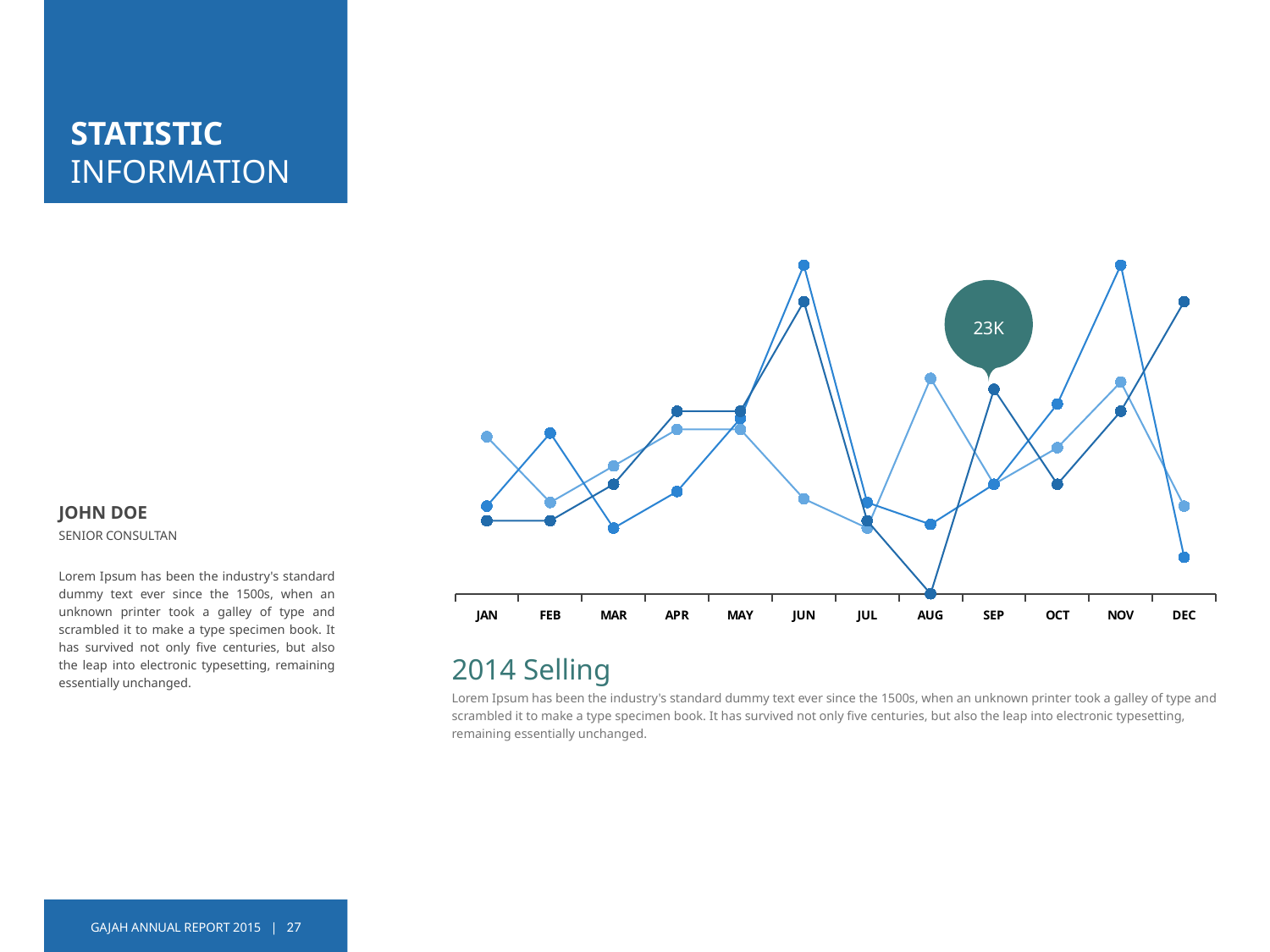
Which month does the 23K callout point to? SEP In which month does the lowest point on the chart occur? AUG What value is shown in the callout label on the chart? 23K How many lines are plotted on the chart? 3 What kind of chart is shown on the slide? line chart What colour is the callout bubble showing 23K? teal green For the darkest blue line, does the value rise or fall from JUN to AUG? fall For the darkest blue line, is the value higher in JUN or in JUL? JUN For the lightest blue line, is the value higher in JAN or in FEB? JAN For the darkest blue line, does the value rise or fall from NOV to DEC? rise What is the title of the chart? 2014 Selling How many months are shown on the x axis of the chart? 12